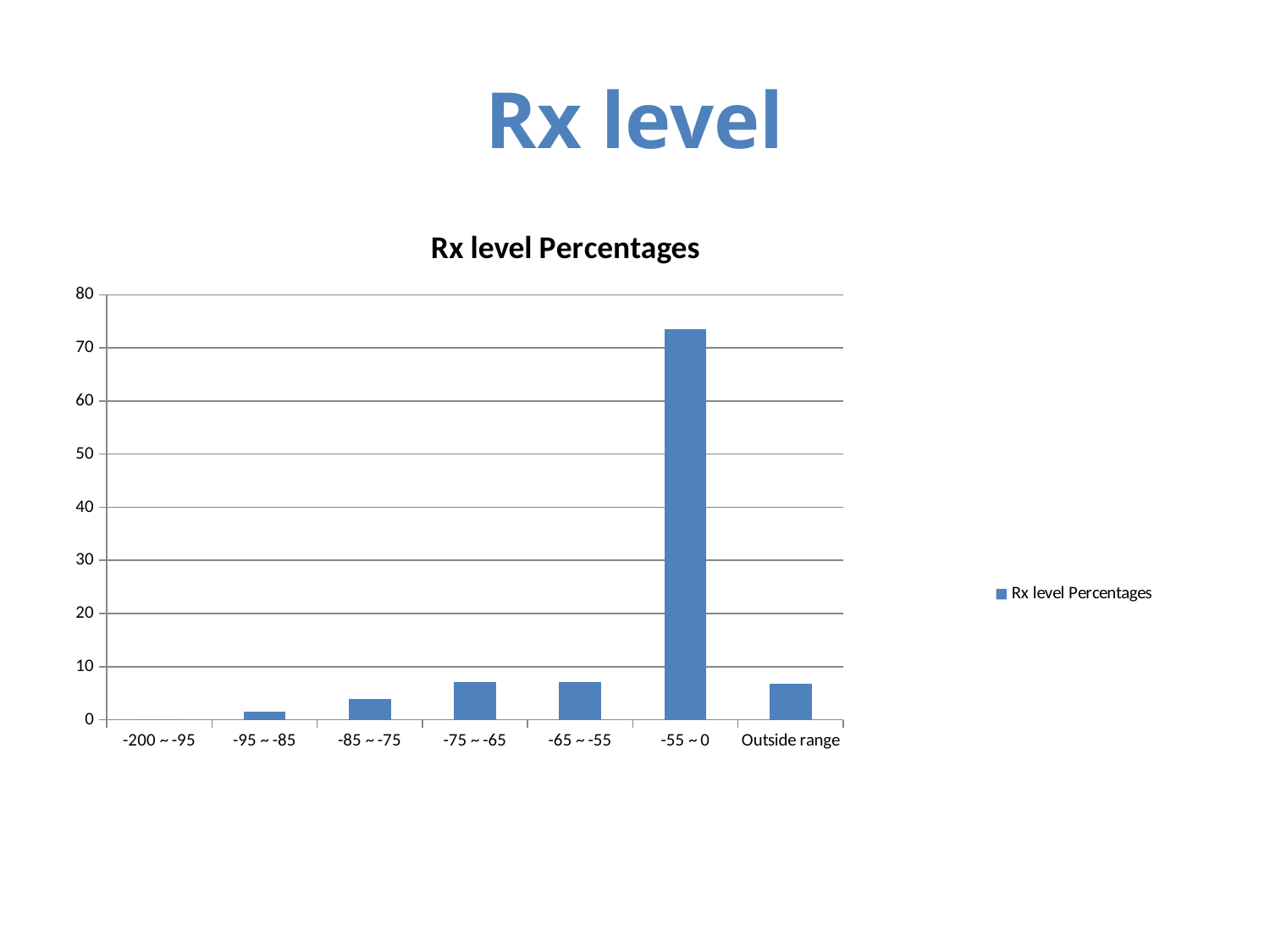
Is the value for -55 ~ 0 greater or less than 70? greater What is the name of the series shown in the legend? Rx level Percentages Is the value for Outside range greater or less than 10? less Which is larger, the value for -55 ~ 0 or the value for -85 ~ -75? -55 ~ 0 Is the value for -85 ~ -75 greater or less than 10? less Which category has the lowest value? -200 ~ -95 Which category has the highest value? -55 ~ 0 Which is larger, the value for -75 ~ -65 or the value for -95 ~ -85? -75 ~ -65 How many series does the legend list? 1 What is the title of the chart? Rx level Percentages How many categories are shown on the x axis of the chart? 7 What kind of chart is shown on the slide? Bar chart